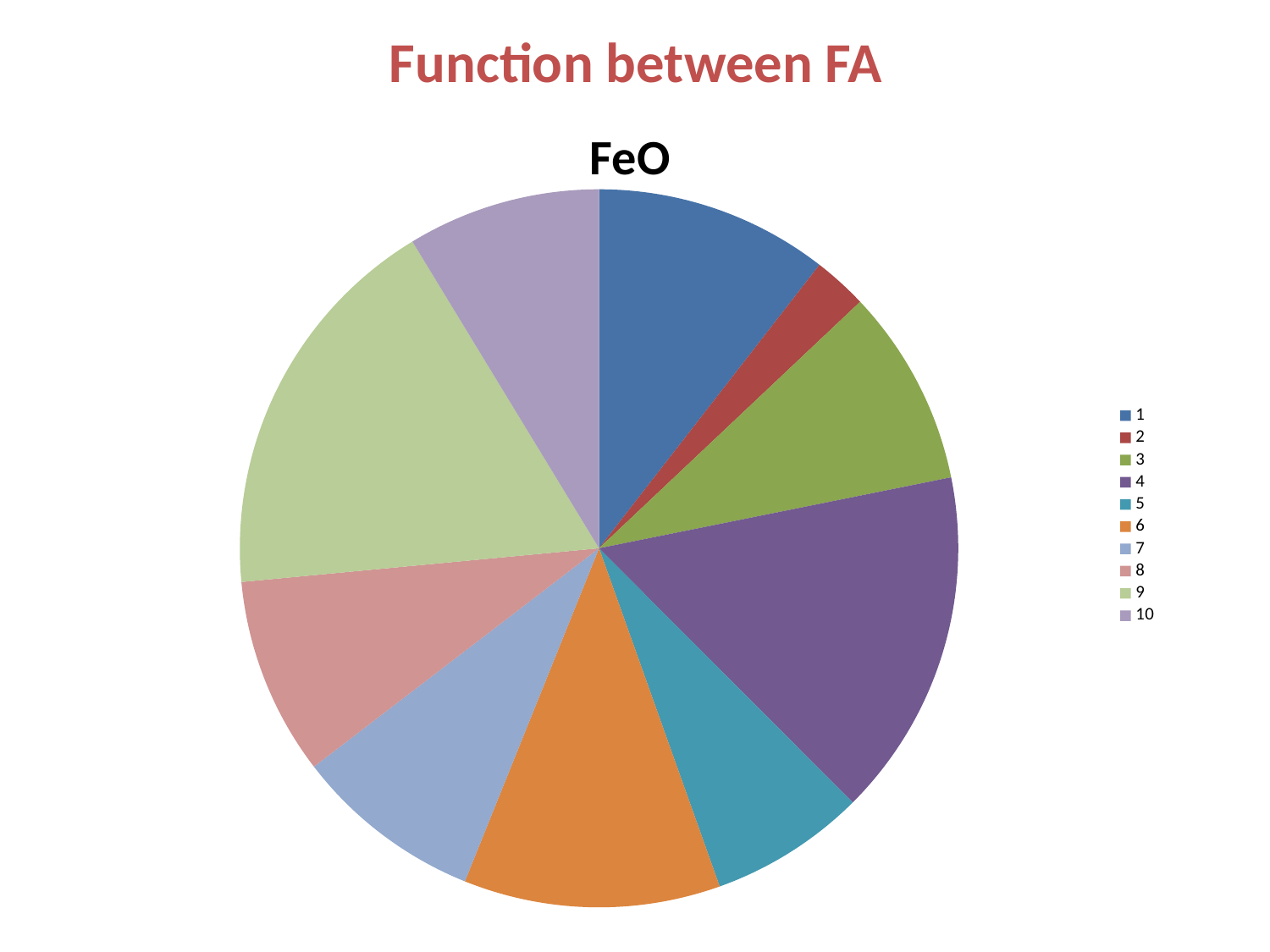
What kind of chart is shown on the slide? pie chart What is the title of the chart? FeO Which slice is larger, category 4 or category 5? 4 Which category has the largest slice of the pie? 9 Which category has the smallest slice of the pie? 2 Which slice is larger, category 2 or category 3? 3 Which slice is larger, category 9 or category 10? 9 How many categories does the pie chart have? 10 What colour is the slice for category 6? orange